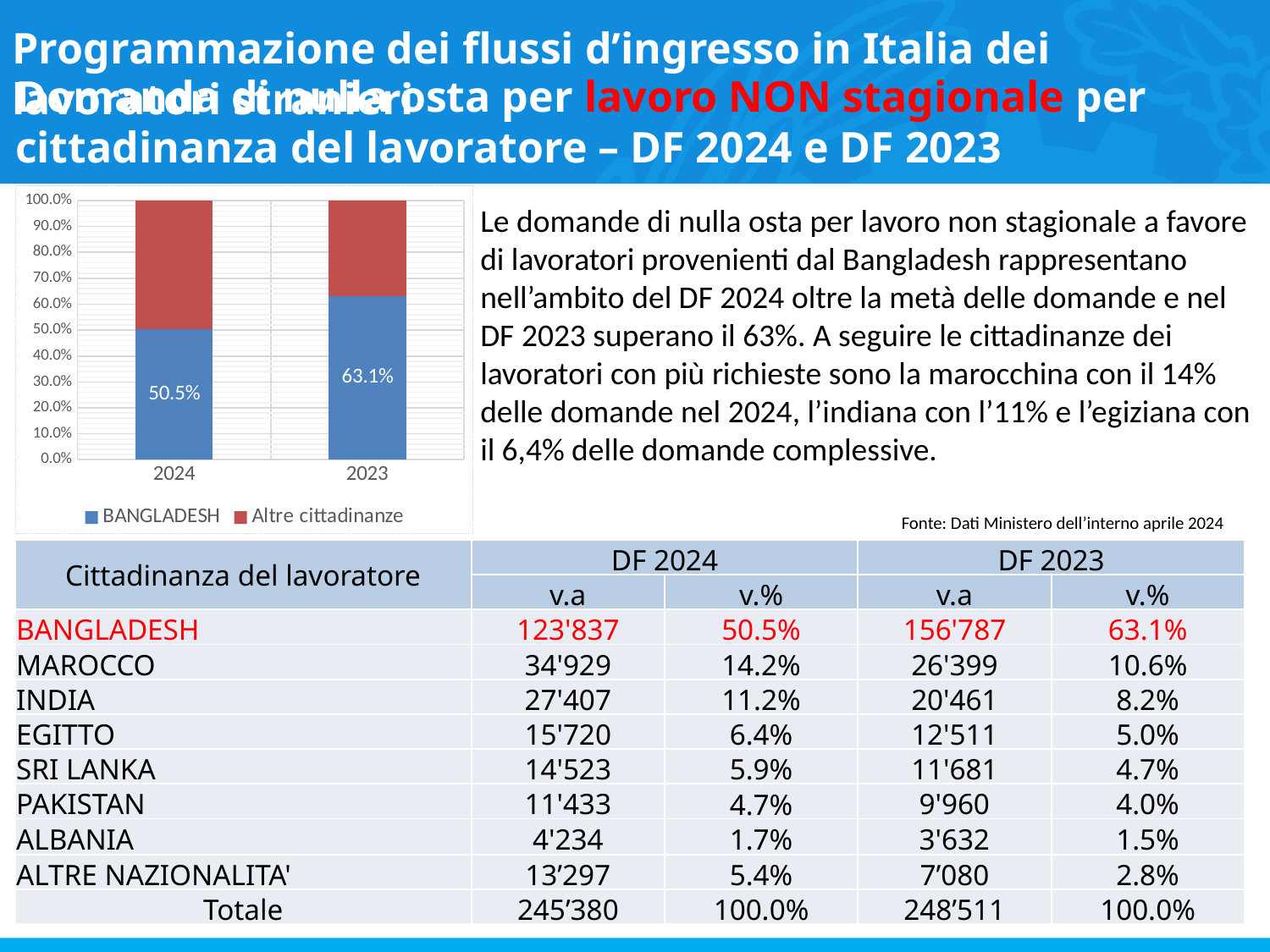
In the stacked bar chart, does the BANGLADESH share rise or fall moving from 2024 to 2023 along the x axis? Rises In the stacked bar chart, which colour represents BANGLADESH? Blue In the stacked bar chart, what is the value shown for BANGLADESH in 2024? 50.5% In the stacked bar chart, is the value for Altre cittadinanze in 2024 greater or less than 40%? greater What are the two legend entries of the stacked bar chart? BANGLADESH and Altre cittadinanze How many categories (years) are shown on the x axis of the stacked bar chart? 2 What kind of chart is shown on the left of the slide? Stacked bar chart In the stacked bar chart, what is the difference between the BANGLADESH share in 2023 and in 2024? 12.6 percentage points In the stacked bar chart, what is the value shown for BANGLADESH in 2023? 63.1% How many series does the legend of the stacked bar chart list? 2 In the stacked bar chart, is the BANGLADESH share larger in 2024 or in 2023? 2023 In the stacked bar chart, is the value for Altre cittadinanze in 2023 greater or less than 50%? less